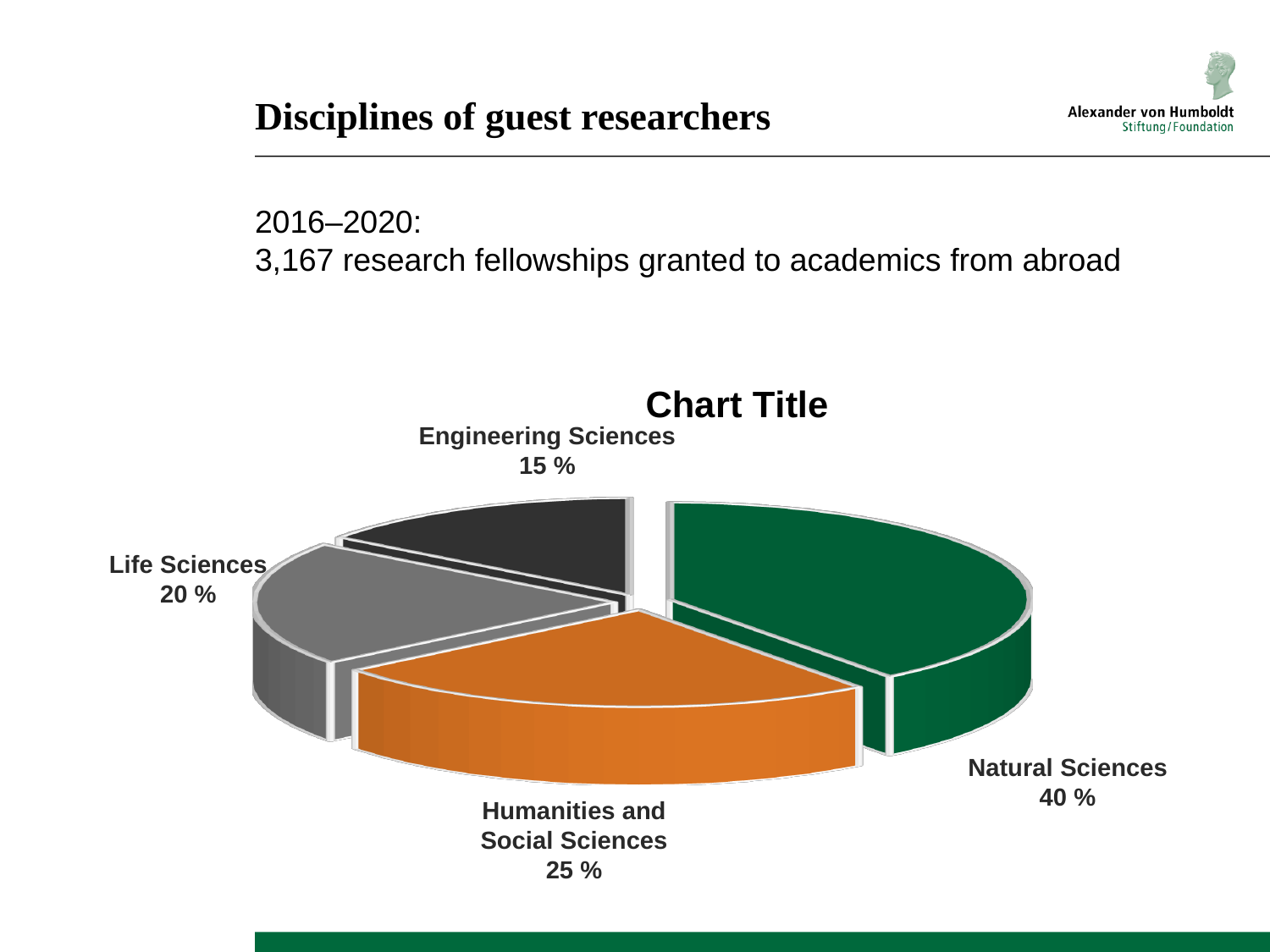
What is the difference in percentage points between Humanities and Social Sciences and Life Sciences? 5 What share of guest researchers is in Life Sciences? 20 % What is the difference in percentage points between Natural Sciences and Engineering Sciences? 25 How many disciplines are shown in the pie chart? 4 What type of chart is shown on the slide? Pie chart What colour is the Natural Sciences slice? Green Which has a larger share, Life Sciences or Humanities and Social Sciences? Humanities and Social Sciences What share of guest researchers is in Engineering Sciences? 15 % Which discipline has the smallest share of guest researchers? Engineering Sciences What share of guest researchers is in Humanities and Social Sciences? 25 % What share of guest researchers is in Natural Sciences? 40 % Which discipline has the largest share of guest researchers? Natural Sciences